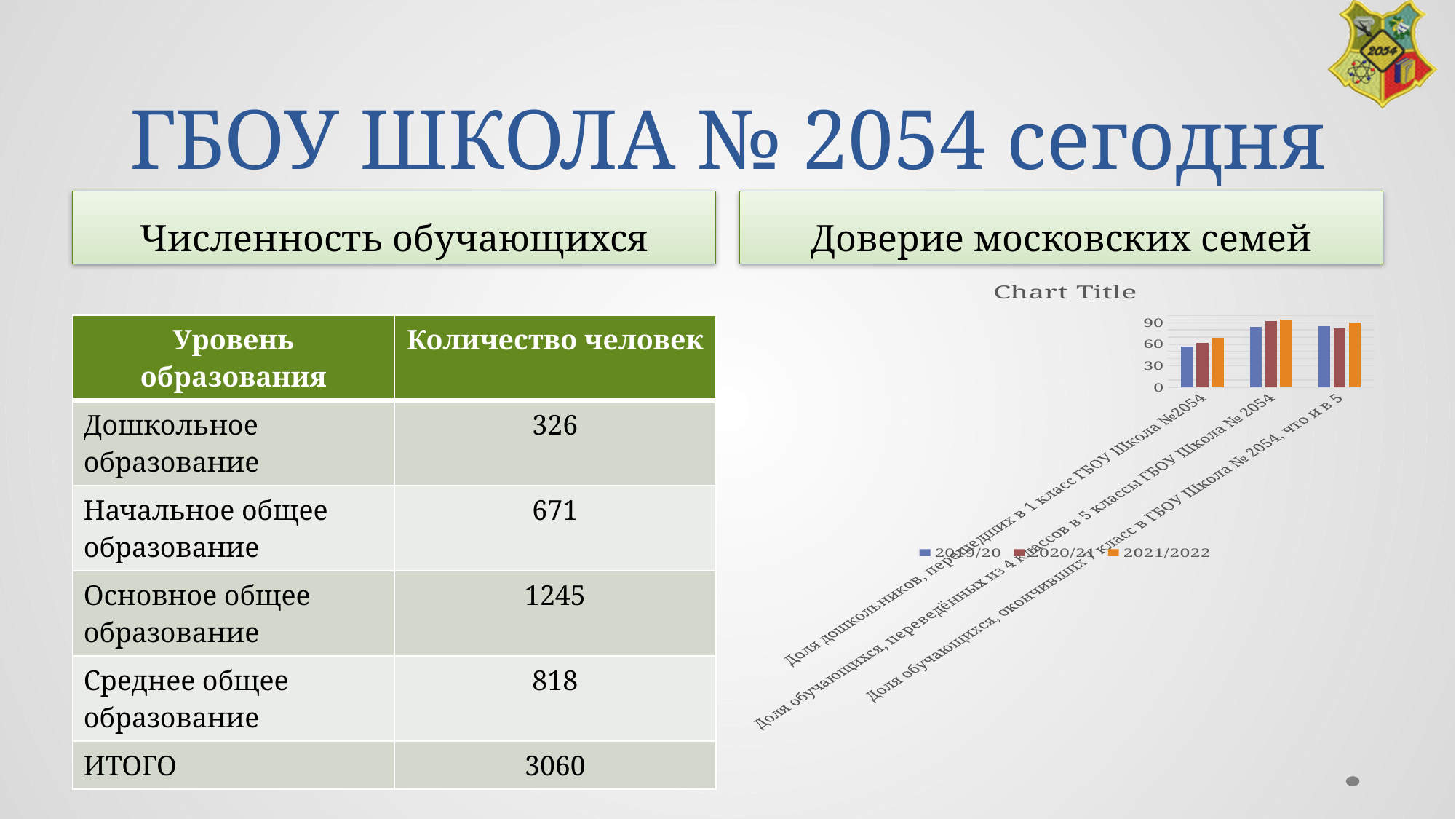
Is the 2021/2022 value for "Доля обучающихся, переведённых из 4 классов в 5 классы ГБОУ Школа № 2054" greater or less than 60? greater How many categories are shown on the x axis of the chart? 3 For the category "Доля дошкольников, перешедших в 1 класс ГБОУ Школа №2054", do the values rise or fall from 2019/20 to 2021/2022? rise For the category "Доля дошкольников, перешедших в 1 класс ГБОУ Школа №2054", which series has the highest bar? 2021/2022 For the category "Доля дошкольников, перешедших в 1 класс ГБОУ Школа №2054", which series has the lowest bar? 2019/20 What are the legend entries of the chart? 2019/20, 2020/21, 2021/2022 What is the title printed above the chart? Chart Title Is the 2020/21 value for "Доля дошкольников, перешедших в 1 класс ГБОУ Школа №2054" greater or less than 90? less For the 2019/20 series, which is larger: the value for "Доля дошкольников, перешедших в 1 класс ГБОУ Школа №2054" or for "Доля обучающихся, переведённых из 4 классов в 5 классы ГБОУ Школа № 2054"? Доля обучающихся, переведённых из 4 классов в 5 классы ГБОУ Школа № 2054 How many series does the legend of the chart list? 3 What kind of chart is shown under "Доверие московских семей"? bar chart